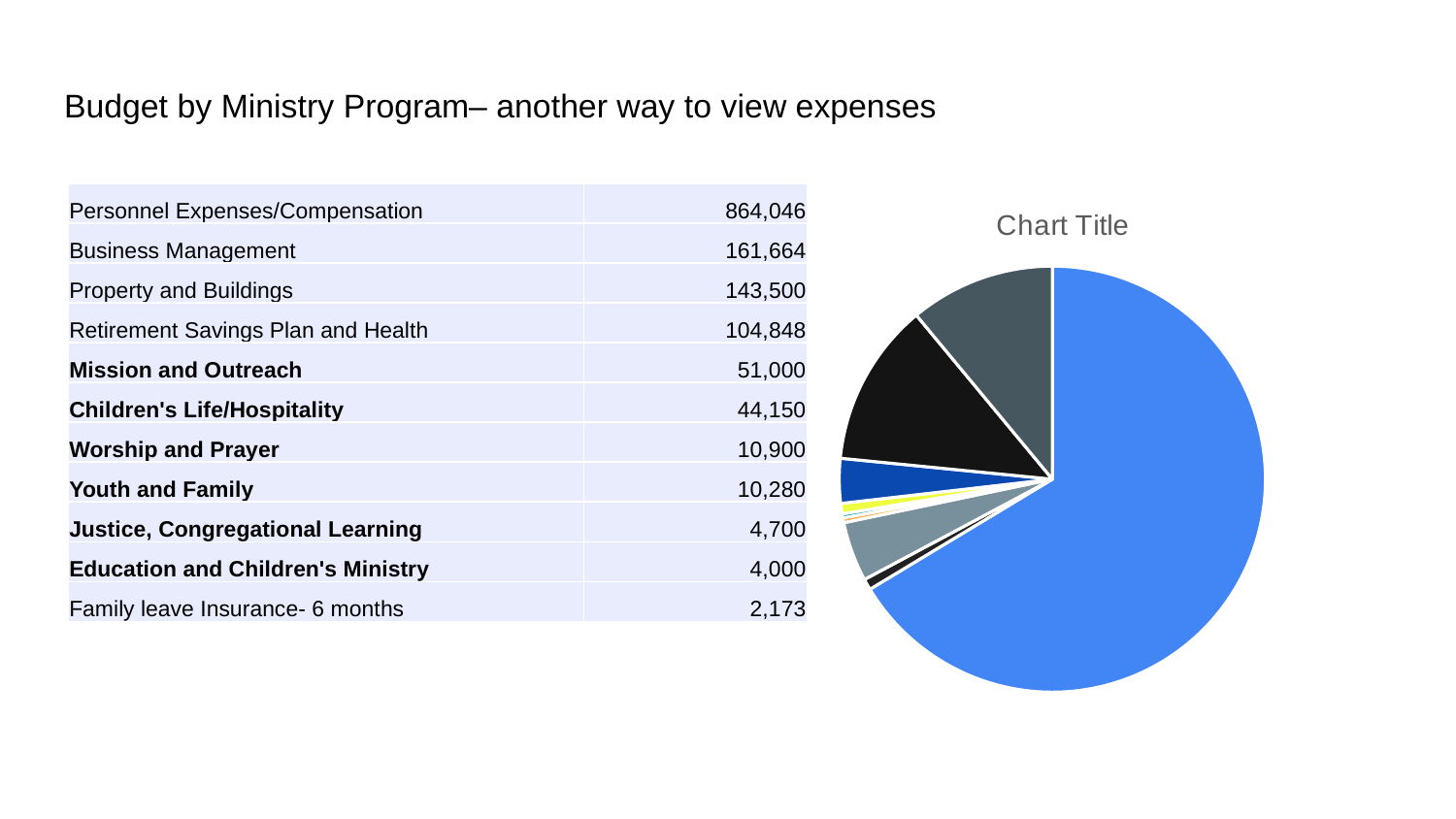
What is the budget amount for Mission and Outreach? 51,000 What kind of chart is shown on the slide? pie chart What is the difference between the budget for Mission and Outreach and Children's Life/Hospitality? 6,850 Which ministry program has the smallest budget amount? Family leave Insurance- 6 months Which ministry program has the largest budget amount? Personnel Expenses/Compensation How many ministry program categories are listed in the budget table? 11 What is the budget amount for Youth and Family? 10,280 Which is larger, the budget for Business Management or for Property and Buildings? Business Management What is the budget amount for Personnel Expenses/Compensation? 864,046 What is the budget amount for Property and Buildings? 143,500 What is the difference between the budget for Personnel Expenses/Compensation and Business Management? 702,382 What is the title shown above the pie chart? Chart Title